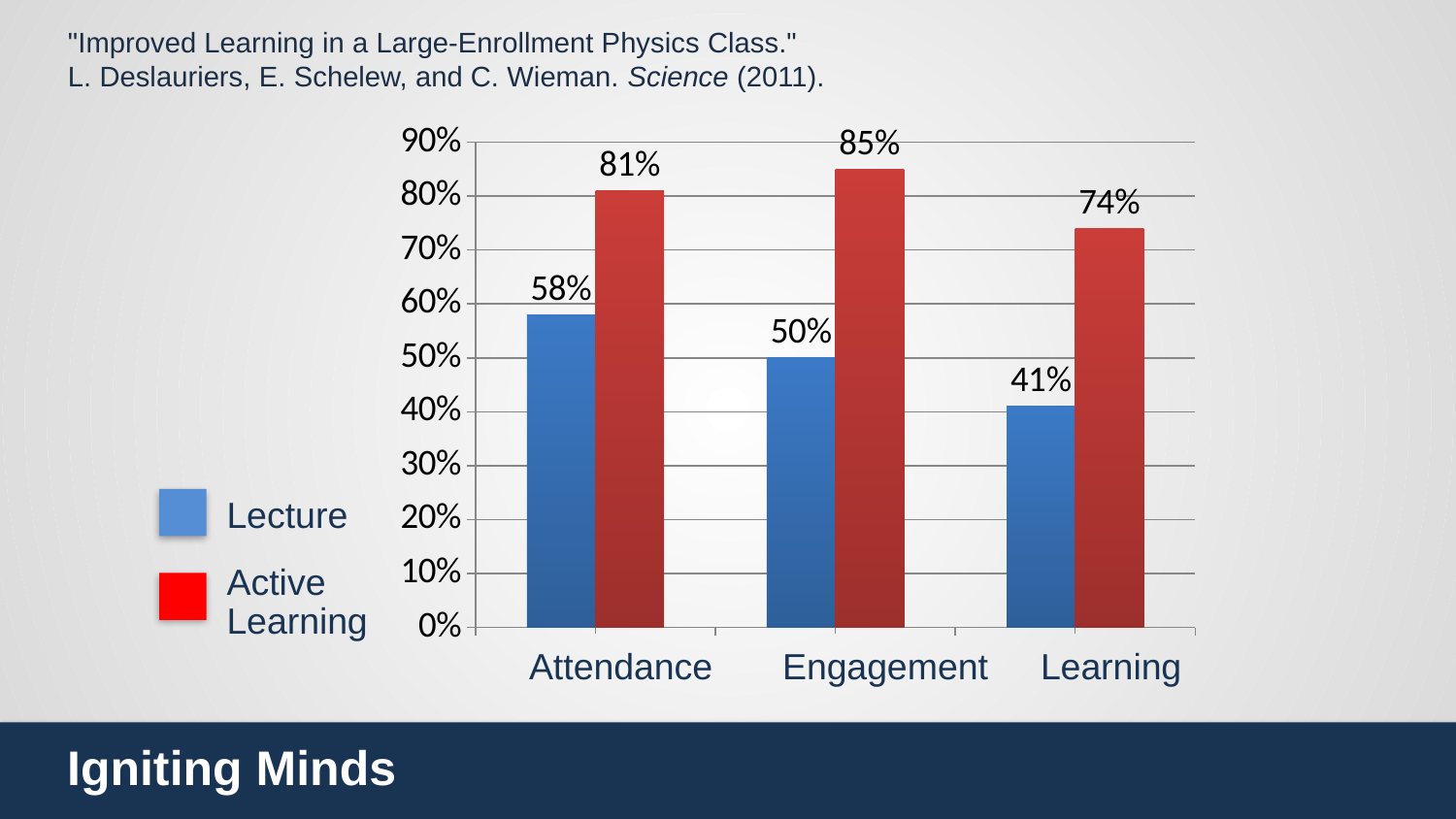
How many series does the legend list? 2 How many categories are shown on the x axis? 3 What is the Lecture value for Attendance? 58% What is the Active Learning value for Engagement? 85% What is the Active Learning value for Learning? 74% What is the Lecture value for Learning? 41% What kind of chart is shown on the slide? Bar chart What is the difference between the Active Learning and Lecture values for Learning? 33% Which is larger for Engagement, the Lecture value or the Active Learning value? Active Learning What is the difference between the Active Learning and Lecture values for Attendance? 23% Which category has the lowest Lecture value? Learning Which category has the highest Active Learning value? Engagement